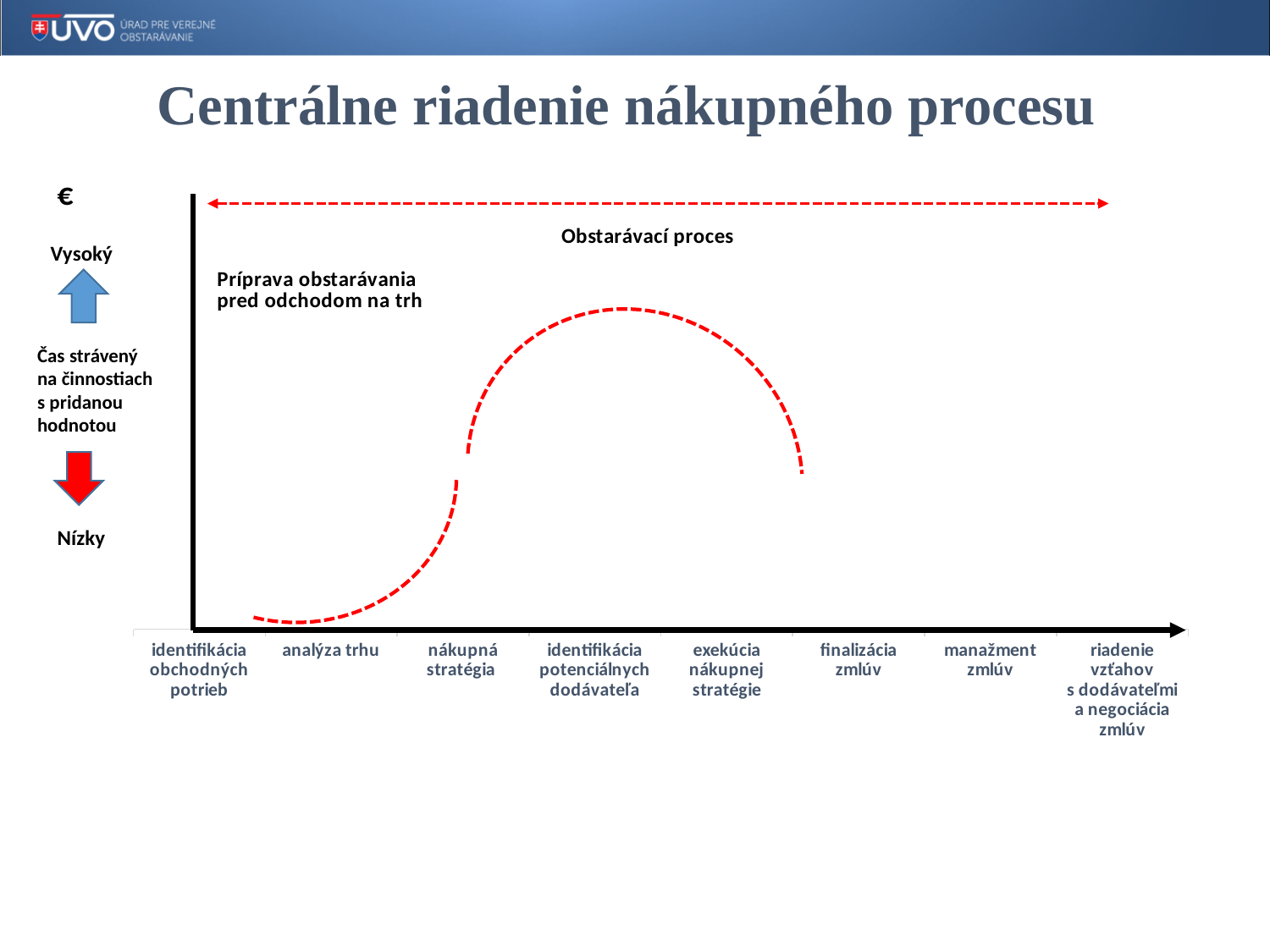
Does the curve rise or fall between 'identifikácia potenciálnych dodávateľa' and 'exekúcia nákupnej stratégie'? falls How many categories are labelled along the x axis of the chart? 8 Does the curve rise or fall between 'analýza trhu' and 'nákupná stratégia'? rises What is the last category on the x axis of the chart? riadenie vzťahov s dodávateľmi a negociácia zmlúv Is the curve higher at 'nákupná stratégia' or at 'identifikácia obchodných potrieb'? nákupná stratégia Near which x-axis category does the dashed red curve reach its highest point? identifikácia potenciálnych dodávateľa Is the curve higher at 'analýza trhu' or at 'identifikácia potenciálnych dodávateľa'? identifikácia potenciálnych dodávateľa What kind of chart is shown on the slide? line chart How does the dashed red curve behave moving from left to right along the x axis? rises then falls What is the first category on the x axis of the chart? identifikácia obchodných potrieb